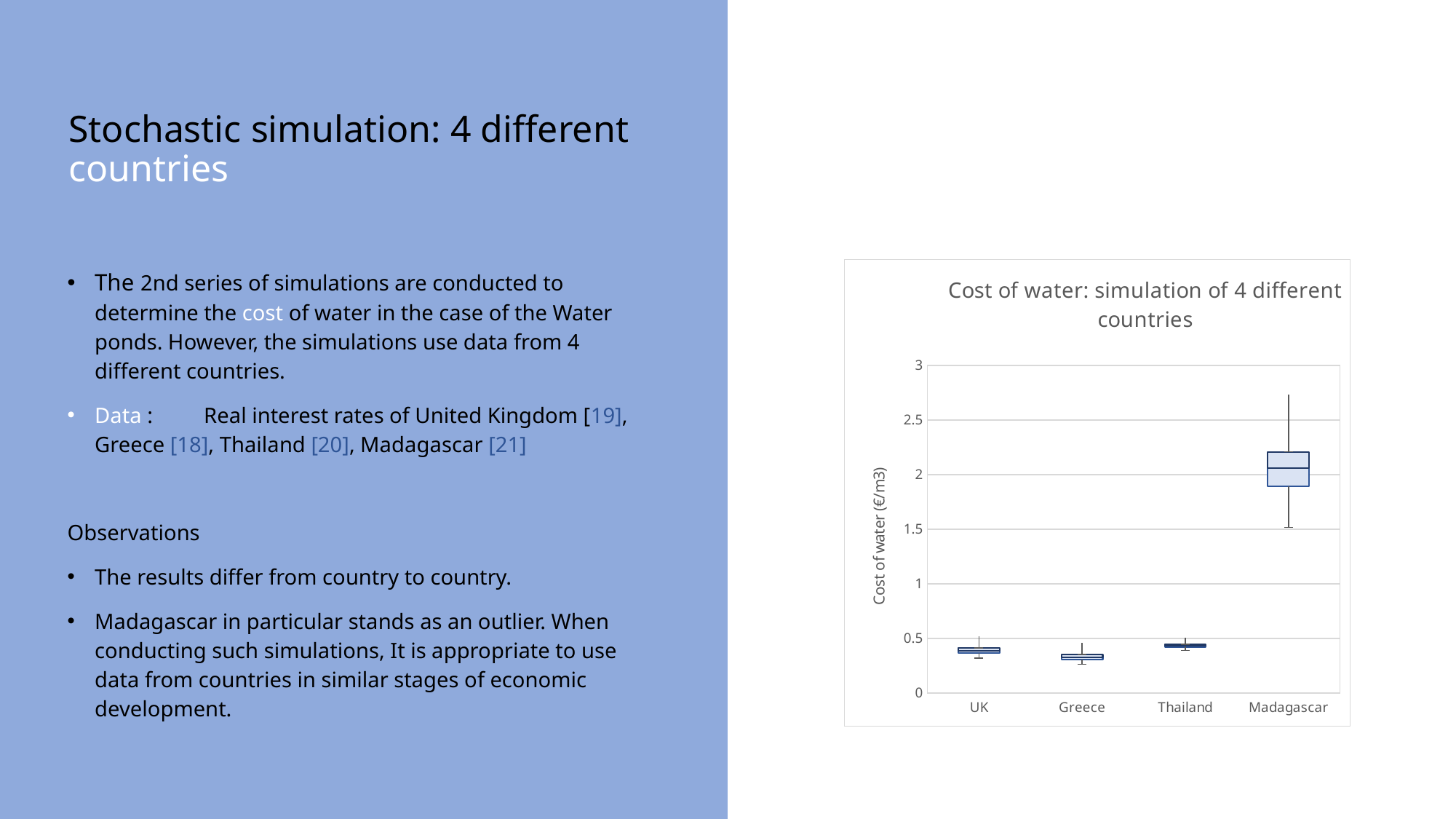
Which country has the lowest cost of water in the chart? Greece Is the top whisker for Madagascar greater or less than 2.5? greater What is the label of the y axis of the chart? Cost of water (€/m3) Is the median cost of water for Madagascar greater or less than 1.5? greater Which has a higher cost of water, Madagascar or the UK? Madagascar What kind of chart is shown on the slide? box-and-whisker plot Is the cost of water for Thailand greater or less than 1? less What is the title of the chart? Cost of water: simulation of 4 different countries How many countries are plotted on the x axis of the chart? 4 Which country has the highest cost of water in the chart? Madagascar Which has a higher cost of water, Thailand or Greece? Thailand